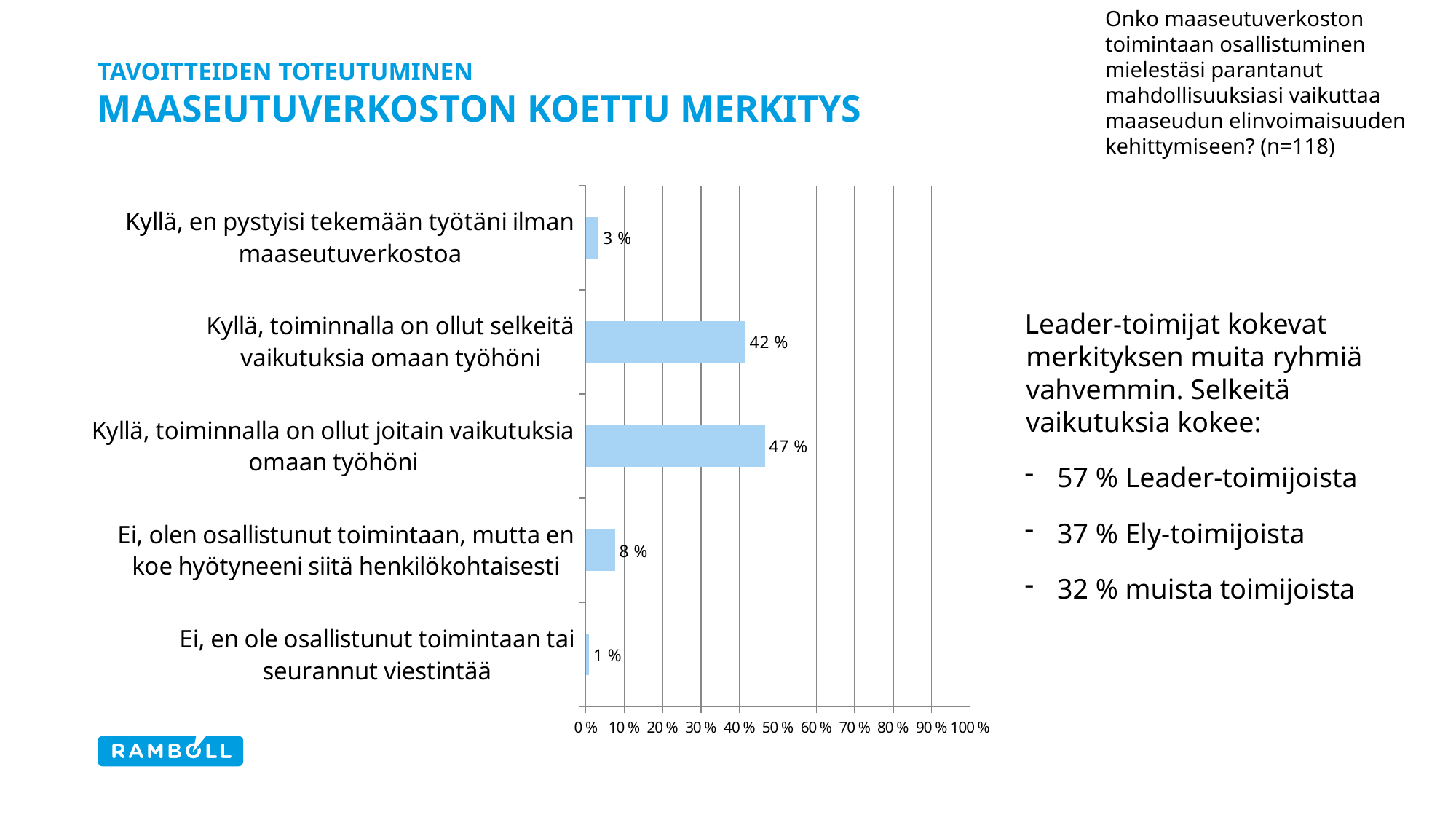
What is the value for "Kyllä, toiminnalla on ollut joitain vaikutuksia omaan työhöni"? 47 % Which is larger: the value for "Ei, olen osallistunut toimintaan, mutta en koe hyötyneeni siitä henkilökohtaisesti" or for "Kyllä, en pystyisi tekemään työtäni ilman maaseutuverkostoa"? Ei, olen osallistunut toimintaan, mutta en koe hyötyneeni siitä henkilökohtaisesti What is the value for "Ei, olen osallistunut toimintaan, mutta en koe hyötyneeni siitä henkilökohtaisesti"? 8 % What kind of chart is shown on the slide? bar chart How many categories does the chart show? 5 What is the maximum value shown on the x axis? 100 % What is the value for "Kyllä, toiminnalla on ollut selkeitä vaikutuksia omaan työhöni"? 42 % Which category has the lowest value? Ei, en ole osallistunut toimintaan tai seurannut viestintää Which category has the highest value? Kyllä, toiminnalla on ollut joitain vaikutuksia omaan työhöni Is the value for "Kyllä, toiminnalla on ollut selkeitä vaikutuksia omaan työhöni" greater or less than 50 %? less What is the value for "Kyllä, en pystyisi tekemään työtäni ilman maaseutuverkostoa"? 3 % What is the difference between the values for "Kyllä, toiminnalla on ollut joitain vaikutuksia omaan työhöni" and "Kyllä, toiminnalla on ollut selkeitä vaikutuksia omaan työhöni"? 5 %